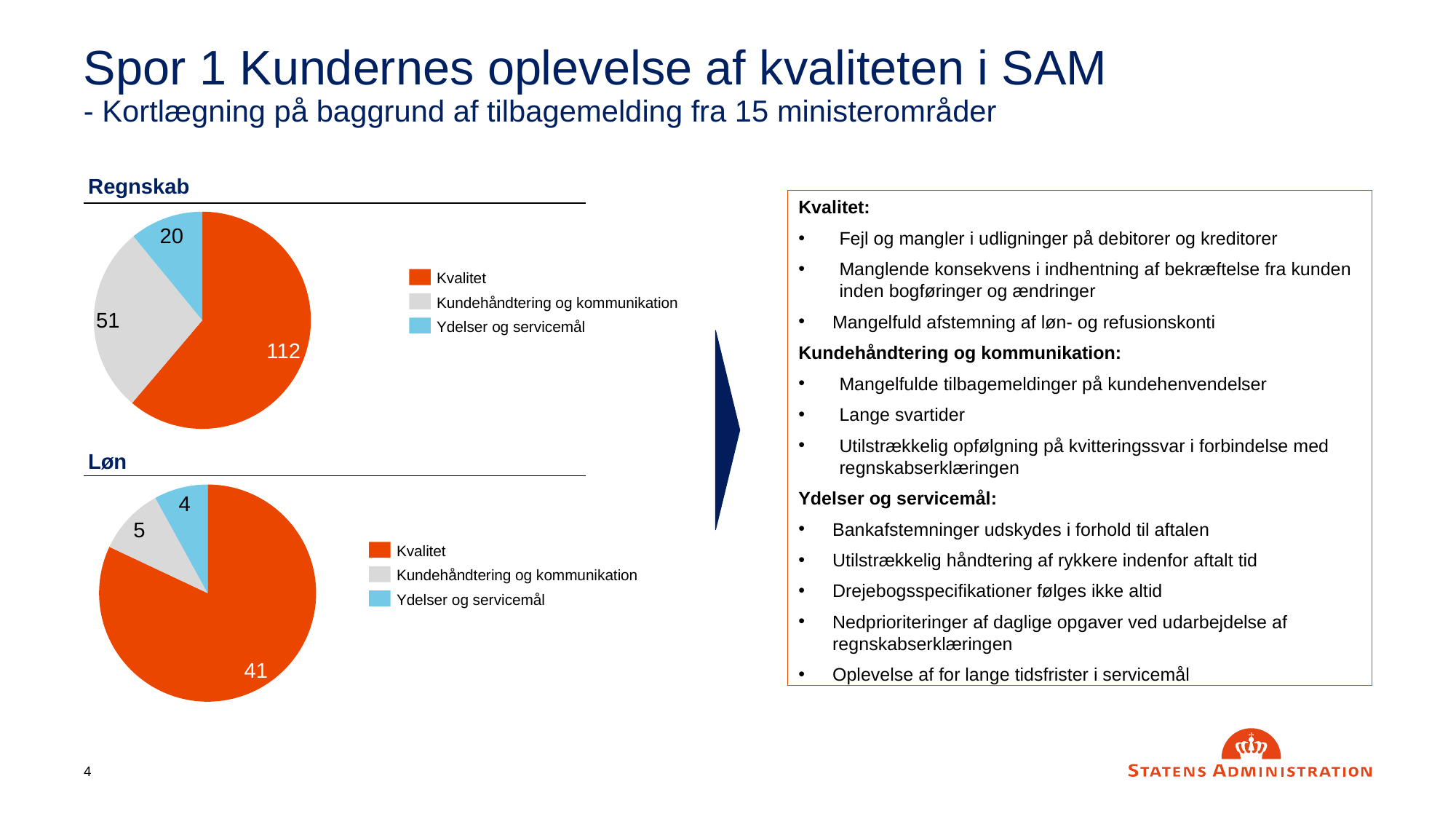
In the Løn chart, which is larger: Kundehåndtering og kommunikation or Ydelser og servicemål? Kundehåndtering og kommunikation In the Regnskab chart, which category has the largest slice? Kvalitet In the Løn chart, what is the value for Kvalitet? 41 In the Regnskab chart, what is the value for Kundehåndtering og kommunikation? 51 In the Regnskab chart, what is the value for Kvalitet? 112 In the Løn chart, what is the value for Ydelser og servicemål? 4 How many slices does the Regnskab pie chart have? 3 What type of chart is the Løn chart? Pie chart In the Løn chart, which category has the smallest slice? Ydelser og servicemål In the Løn chart, what share of the pie does Kvalitet represent? 82% In the Regnskab chart, what is the difference between the values for Kvalitet and Kundehåndtering og kommunikation? 61 In the Løn chart, what is the total of all slices? 50